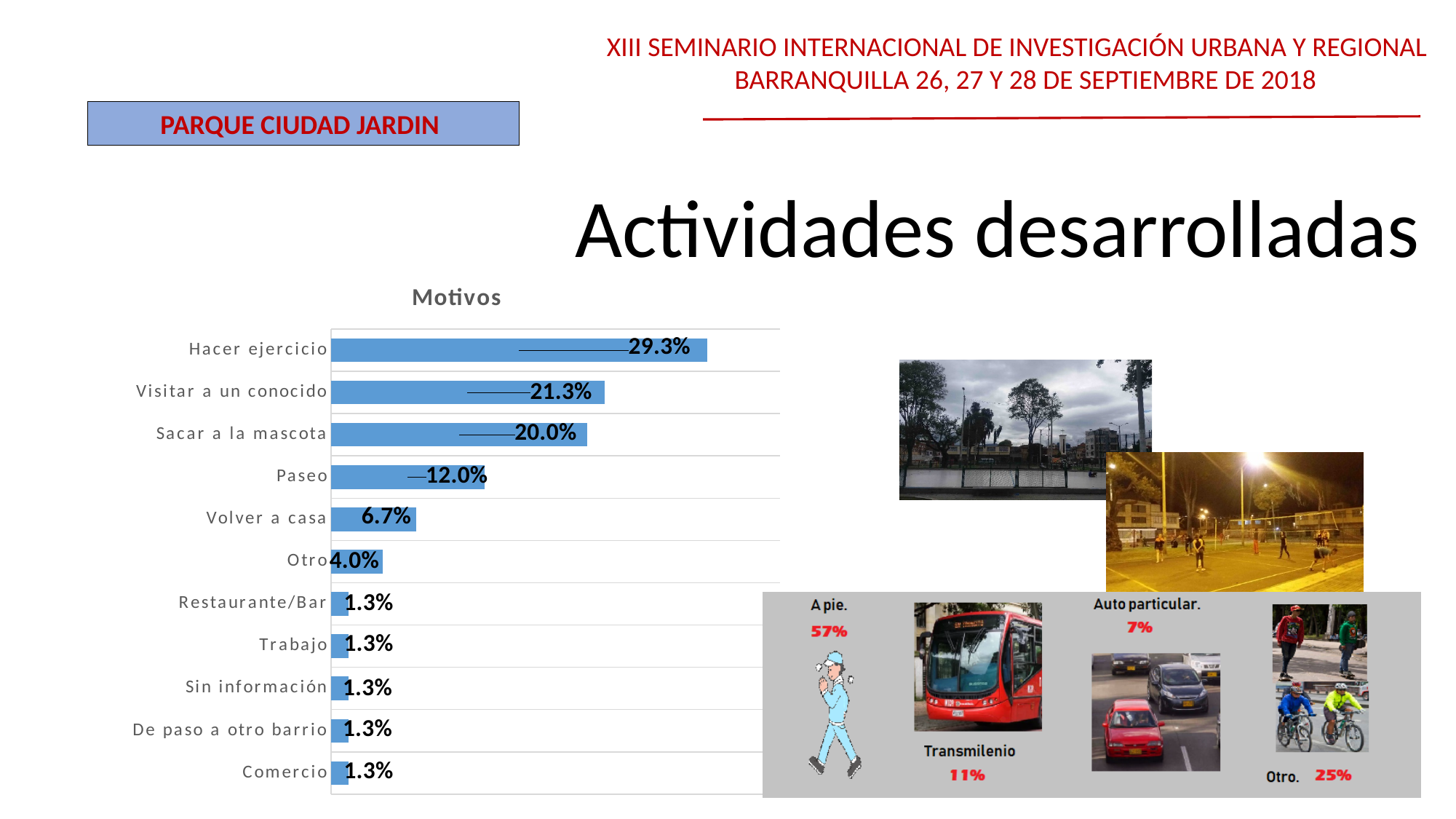
What is the value for Volver a casa in the Motivos chart? 6.7% What kind of chart is the Motivos chart? Bar chart How many categories are shown in the Motivos chart? 11 Which is larger in the Motivos chart, Volver a casa or Otro? Volver a casa What is the value for Sacar a la mascota in the Motivos chart? 20.0% What is the title of the chart on the slide? Motivos What is the value for Hacer ejercicio in the Motivos chart? 29.3% Which category has the highest value in the Motivos chart? Hacer ejercicio What is the difference between Hacer ejercicio and Visitar a un conocido in the Motivos chart? 8.0% What is the value for Paseo in the Motivos chart? 12.0% Which is larger in the Motivos chart, Visitar a un conocido or Sacar a la mascota? Visitar a un conocido What is the difference between Sacar a la mascota and Paseo in the Motivos chart? 8.0%